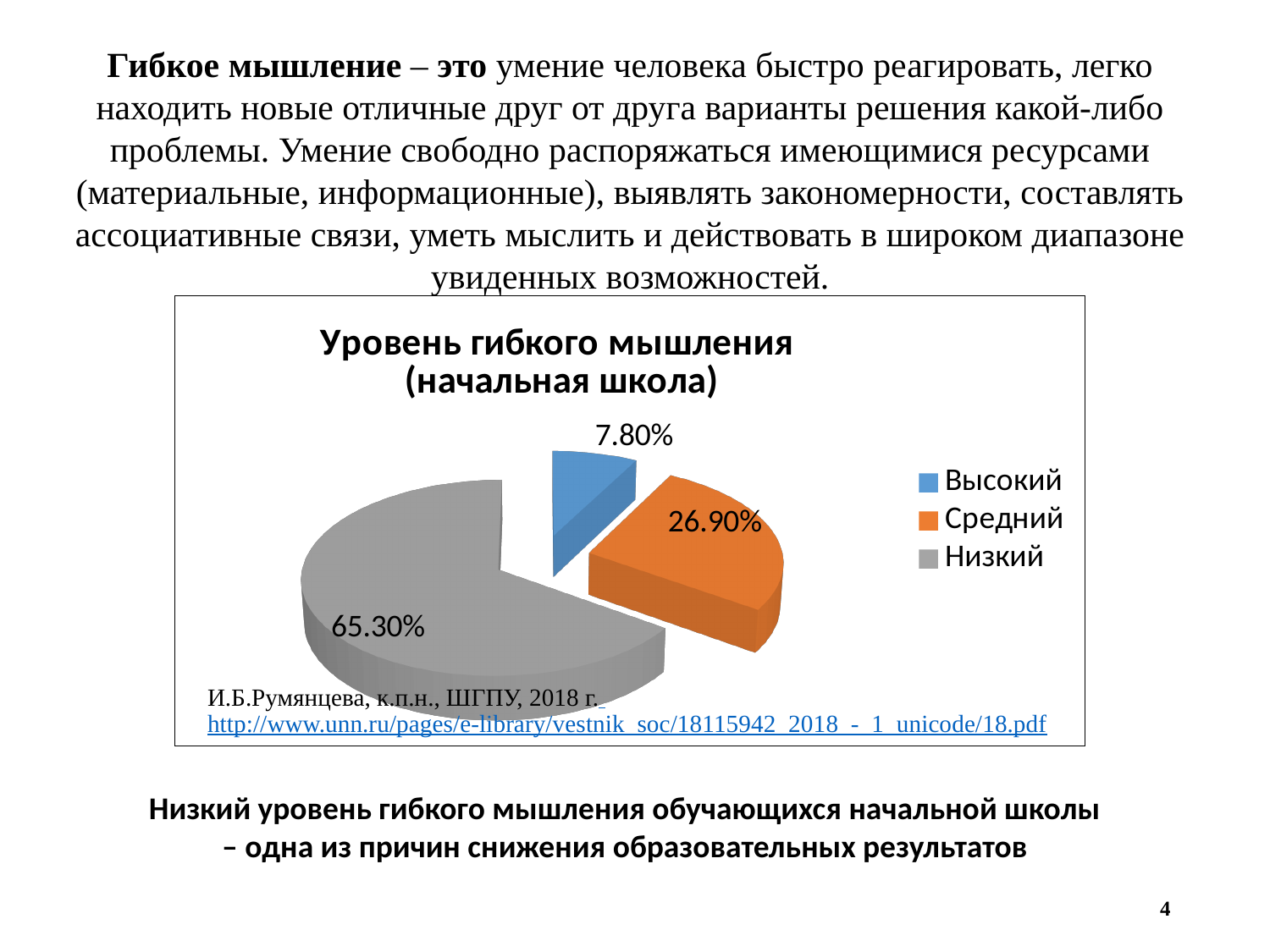
What is the title of the chart? Уровень гибкого мышления (начальная школа) Which is larger, the value for Средний or the value for Высокий? Средний What is the difference between the Средний and Высокий values? 19.10% What is the value for the Средний category? 26.90% What type of chart is shown on the slide? Pie chart What is the value for the Высокий category? 7.80% Which category has the smallest share of the pie? Высокий What is the difference between the Низкий and Средний values? 38.40% Which colour represents the Средний category in the legend? Orange Which category has the largest share of the pie? Низкий What is the value for the Низкий category? 65.30% How many categories does the pie chart have? 3